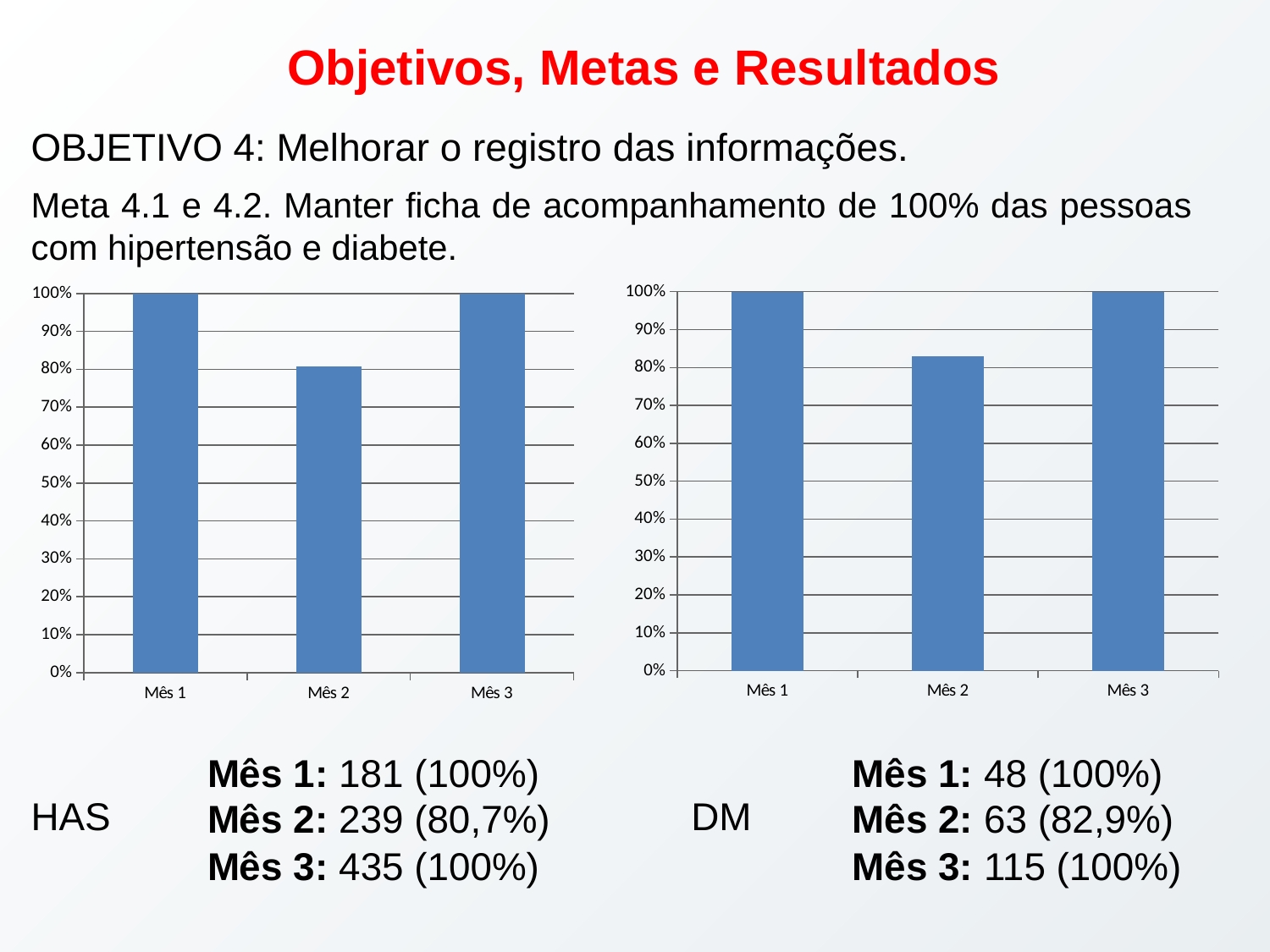
In the left chart, which month has the lowest value? Mês 2 In the right chart, is the value for Mês 2 greater or less than 80%? greater How many categories does the left chart show on its x axis? 3 In the right chart, what is the value for Mês 2? 82,9% What is the difference between the Mês 3 and Mês 2 values in the left chart? 19,3% In the left chart, what is the value for Mês 1? 100% In the right chart, what is the value for Mês 3? 100% In the left chart, is the value for Mês 2 greater or less than 90%? less In the left chart, what is the value for Mês 2? 80,7% In the right chart, which month has the lowest value? Mês 2 In the right chart, which is larger, the value for Mês 1 or the value for Mês 2? Mês 1 What kind of chart is the left chart on the slide? bar chart